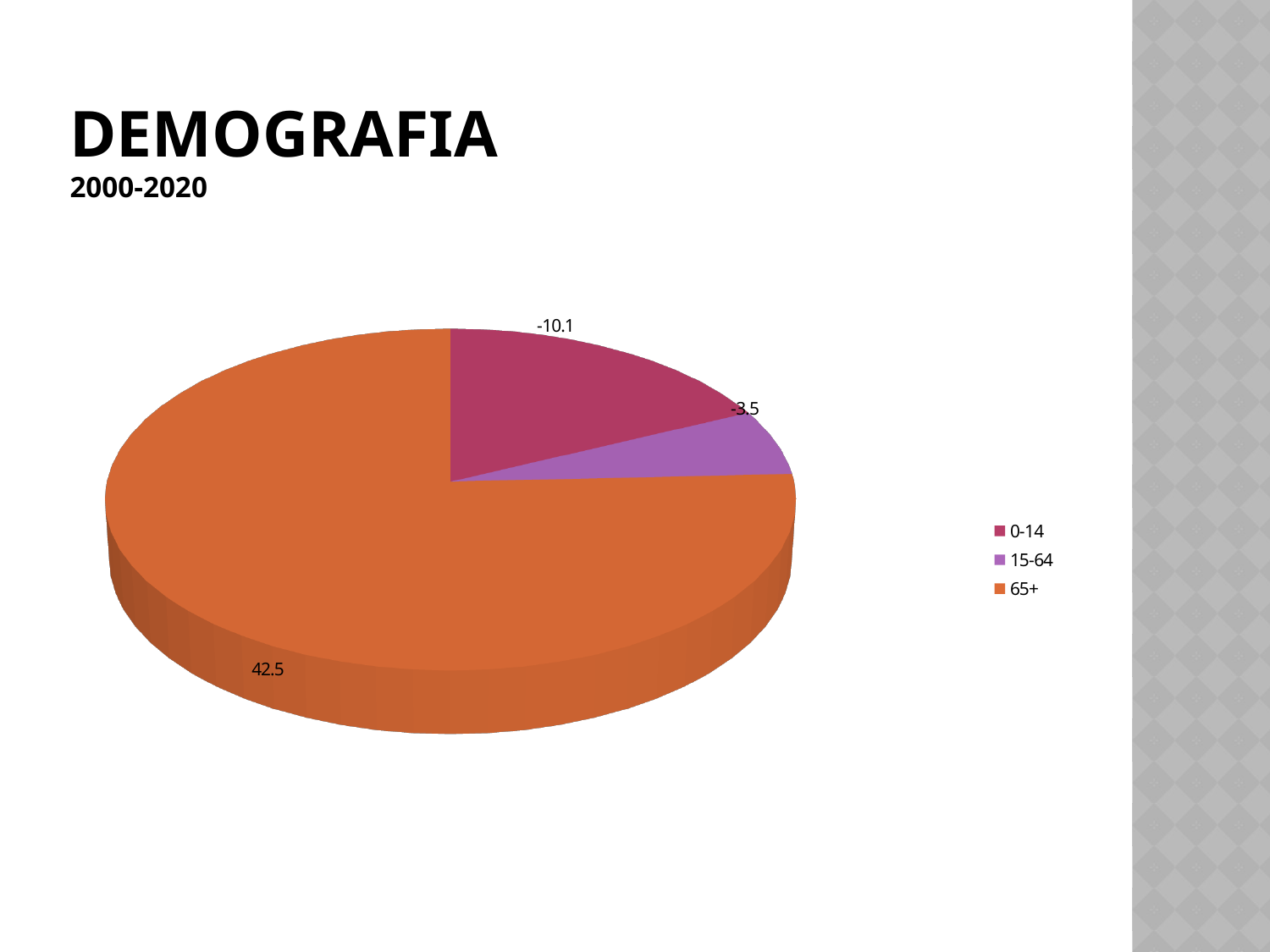
Which category has the lowest value in the pie chart? 0-14 What is the title of the slide containing the chart? DEMOGRAFIA Which category has the highest value in the pie chart? 65+ How many categories does the pie chart have? 3 What is the difference between the value for 65+ and the value for 0-14? 52.6 Which has the higher value, 0-14 or 15-64? 15-64 What is the difference between the value for 15-64 and the value for 0-14? 6.6 What colour is the 65+ slice in the pie chart? orange What is the value shown for the 65+ slice? 42.5 What kind of chart is shown on the slide? pie chart What is the value shown for the 0-14 slice? -10.1 What is the value shown for the 15-64 slice? -3.5